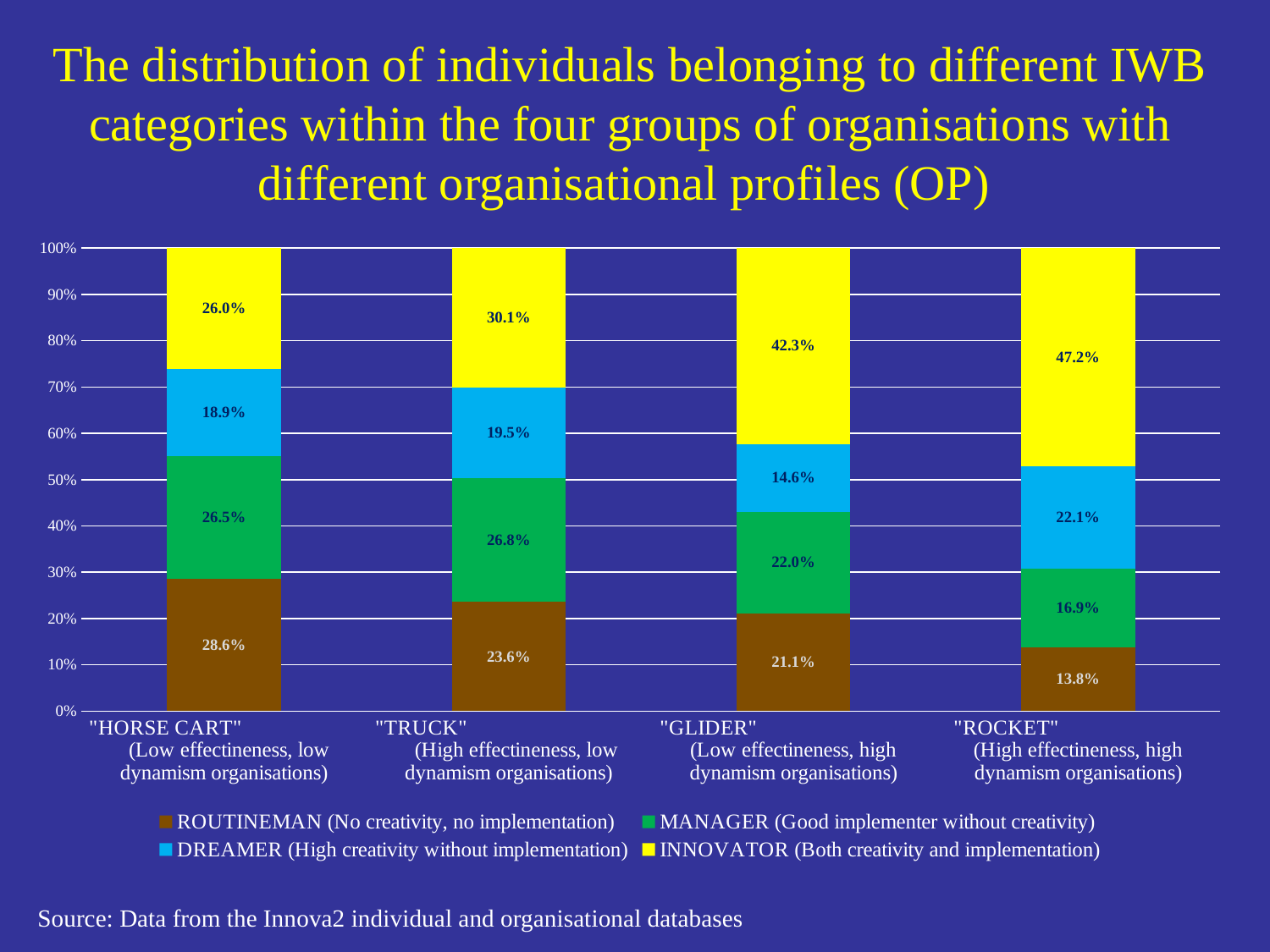
What is the DREAMER value for "GLIDER" organisations? 14.6% What is the difference between the INNOVATOR share in "ROCKET" and in "HORSE CART" organisations? 21.2% Which organisation group has the highest INNOVATOR share? "ROCKET" What is the MANAGER value for "TRUCK" organisations? 26.8% How many series does the legend list? 4 Which is larger: the DREAMER share in "TRUCK" or in "ROCKET" organisations? "ROCKET" How many organisation groups are shown on the x axis? 4 What is the INNOVATOR share for "ROCKET" organisations? 47.2% What percentage of individuals in "HORSE CART" organisations are ROUTINEMAN? 28.6% Which colour represents the INNOVATOR category in the chart? Yellow Which organisation group has the lowest ROUTINEMAN share? "ROCKET" What kind of chart is shown on the slide? Stacked bar chart